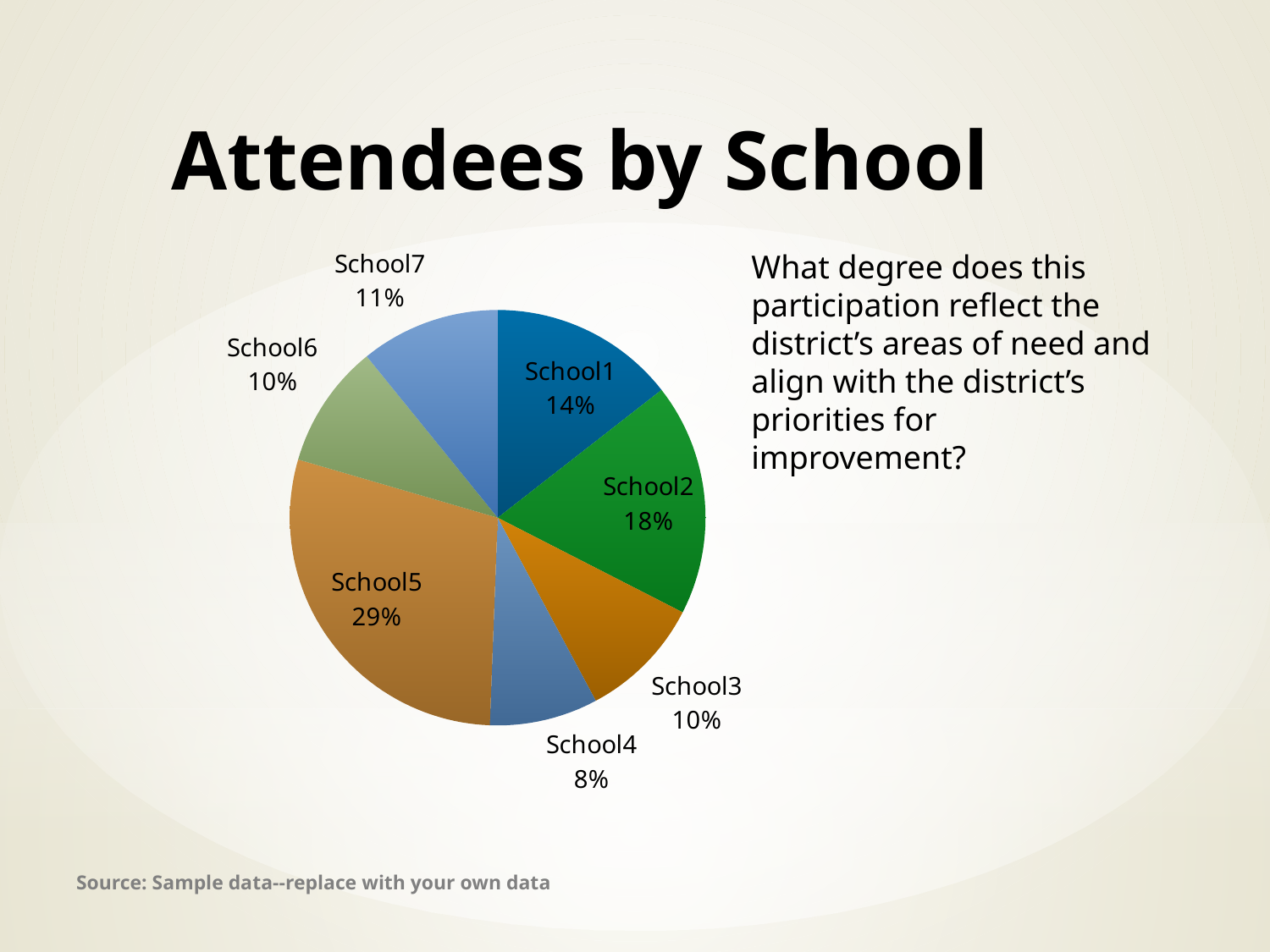
What is the difference in percentage points between School5 and School2? 11 What percentage is shown for School2? 18% What share of attendees does School5 account for? 29% Which school has the smallest share of attendees? School4 How many schools are shown in the pie chart? 7 What is the difference in percentage points between School1 and School4? 6 Which has a larger share, School1 or School6? School1 What percentage is shown for School4? 8% What percentage is shown for School7? 11% Which school has the largest share of attendees? School5 What kind of chart is shown on the slide? pie chart What is the title of the slide containing the chart? Attendees by School